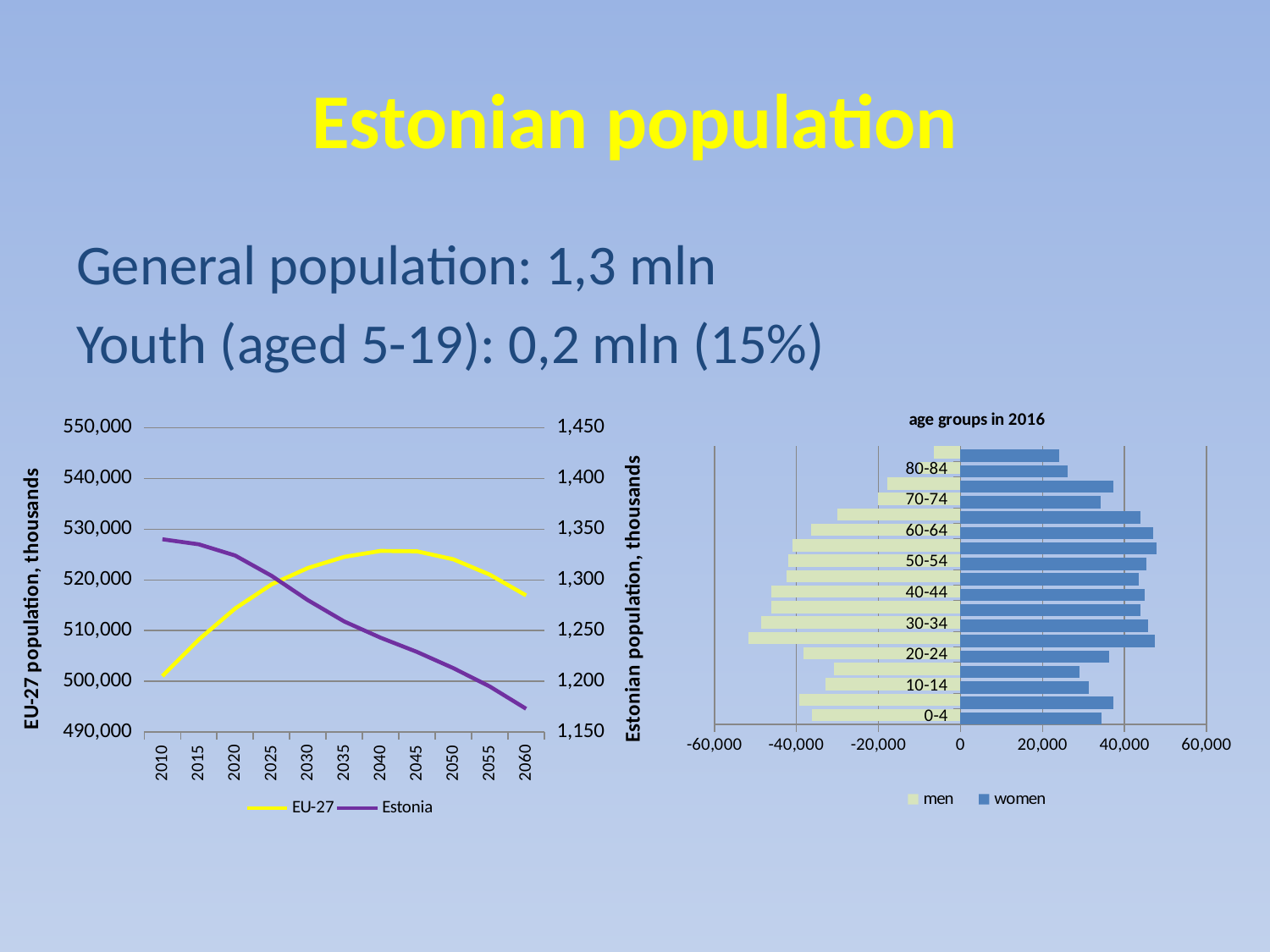
What kind of chart is the right chart titled 'age groups in 2016'? bar chart In the left chart, is the EU-27 value in 2010 greater or less than 510,000? less In the left chart, does the Estonia line rise or fall from 2010 to 2060? fall What kind of chart is the left chart showing EU-27 and Estonian population? line chart How many series does the legend of the left chart list? 2 How many year labels are shown on the x axis of the left chart? 11 In the left chart, is the Estonia value in 2060 greater or less than 1,200? less What are the two series named in the legend of the left chart? EU-27 and Estonia In the 'age groups in 2016' chart, which is larger for the 80-84 age group, men or women? women How many series does the legend of the 'age groups in 2016' chart list? 2 In the left chart, is the Estonia value in 2010 greater or less than 1,300? greater